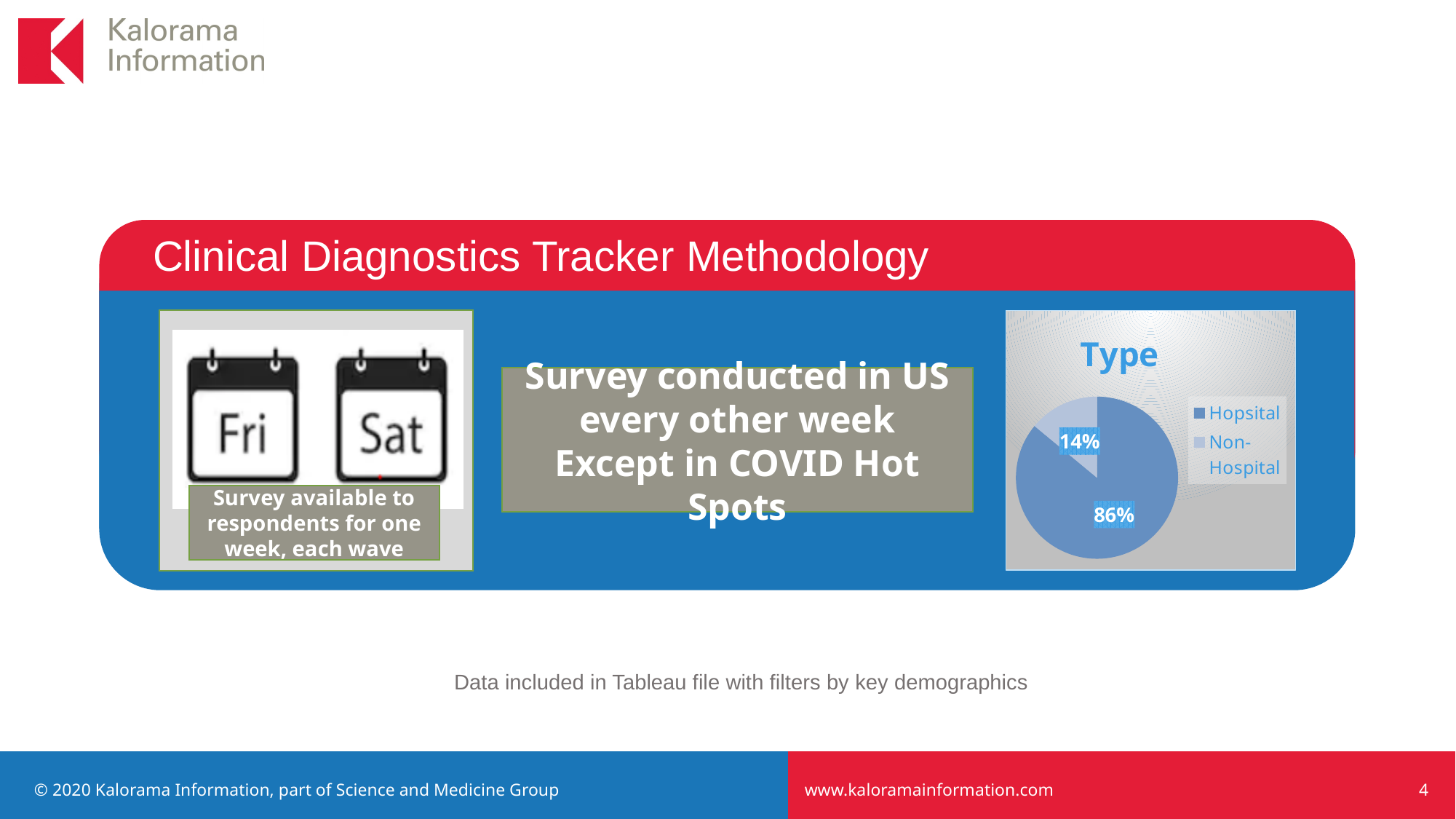
What is the difference in percentage points between the Hospital and Non-Hospital slices? 72 How many entries does the legend of the pie chart list? 2 What is the title of the chart on the slide? Type What kind of chart is shown on the slide? pie chart Is the Hospital share in the pie chart greater or less than 50%? greater What share of the pie chart is Hospital? 86% Which is larger in the pie chart, Hospital or Non-Hospital? Hospital Which category has the smallest slice in the pie chart? Non-Hospital What share of the pie chart is Non-Hospital? 14% Which category has the largest slice in the pie chart? Hospital Which slice of the pie chart is shown in the lighter blue colour? Non-Hospital How many slices does the pie chart have? 2